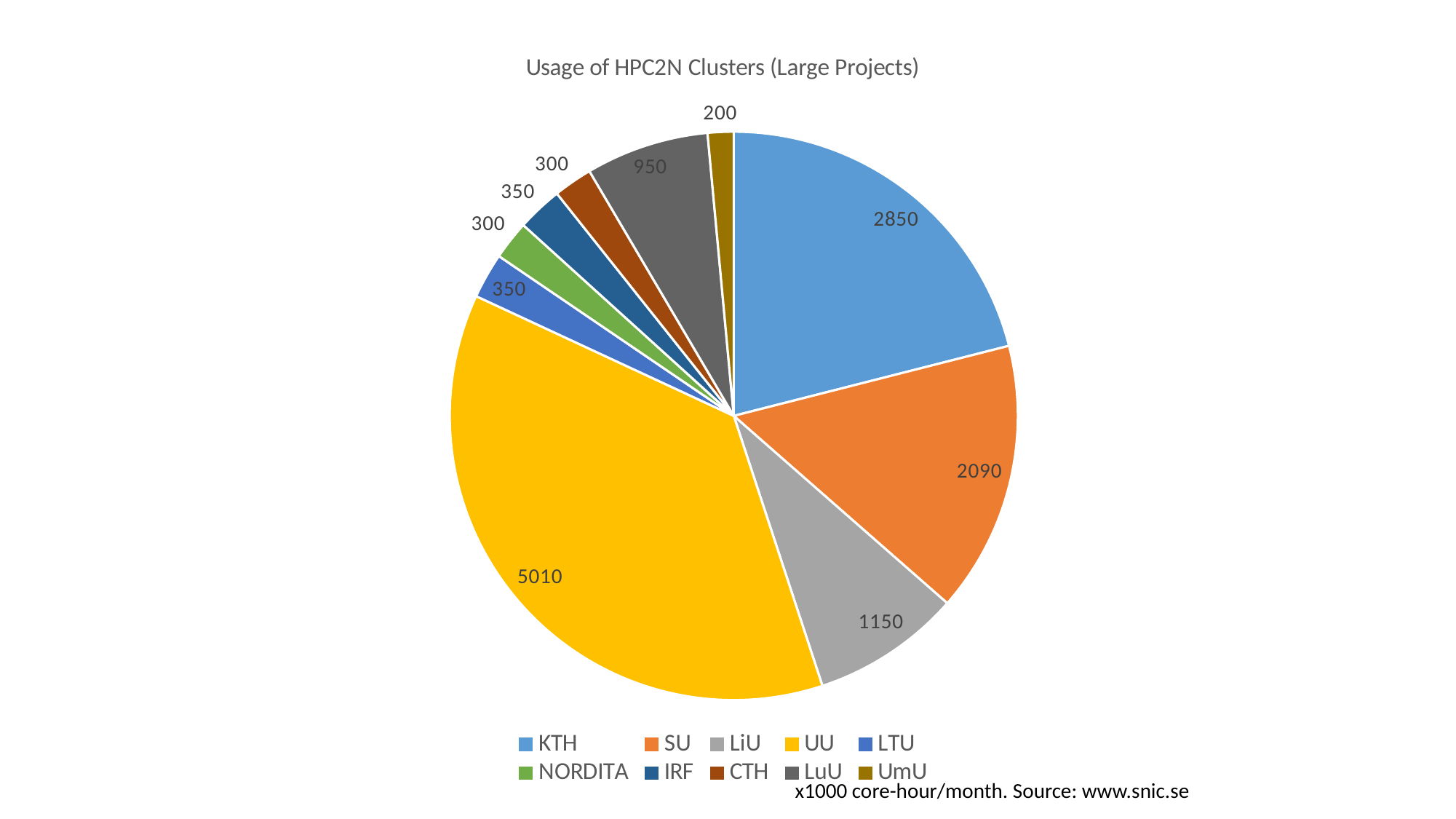
What is the title of the chart? Usage of HPC2N Clusters (Large Projects) What is the value for KTH? 2850 Which category has the smallest slice? UmU What colour is the slice for UU? Yellow What is the value for LuU? 950 What is the value for UU? 5010 Which is larger, the value for SU or the value for LiU? SU Which category has the largest slice? UU What is the difference between the values for KTH and SU? 760 How many categories does the legend list? 10 What type of chart is shown on the slide? Pie chart What is the difference between the values for UU and KTH? 2160